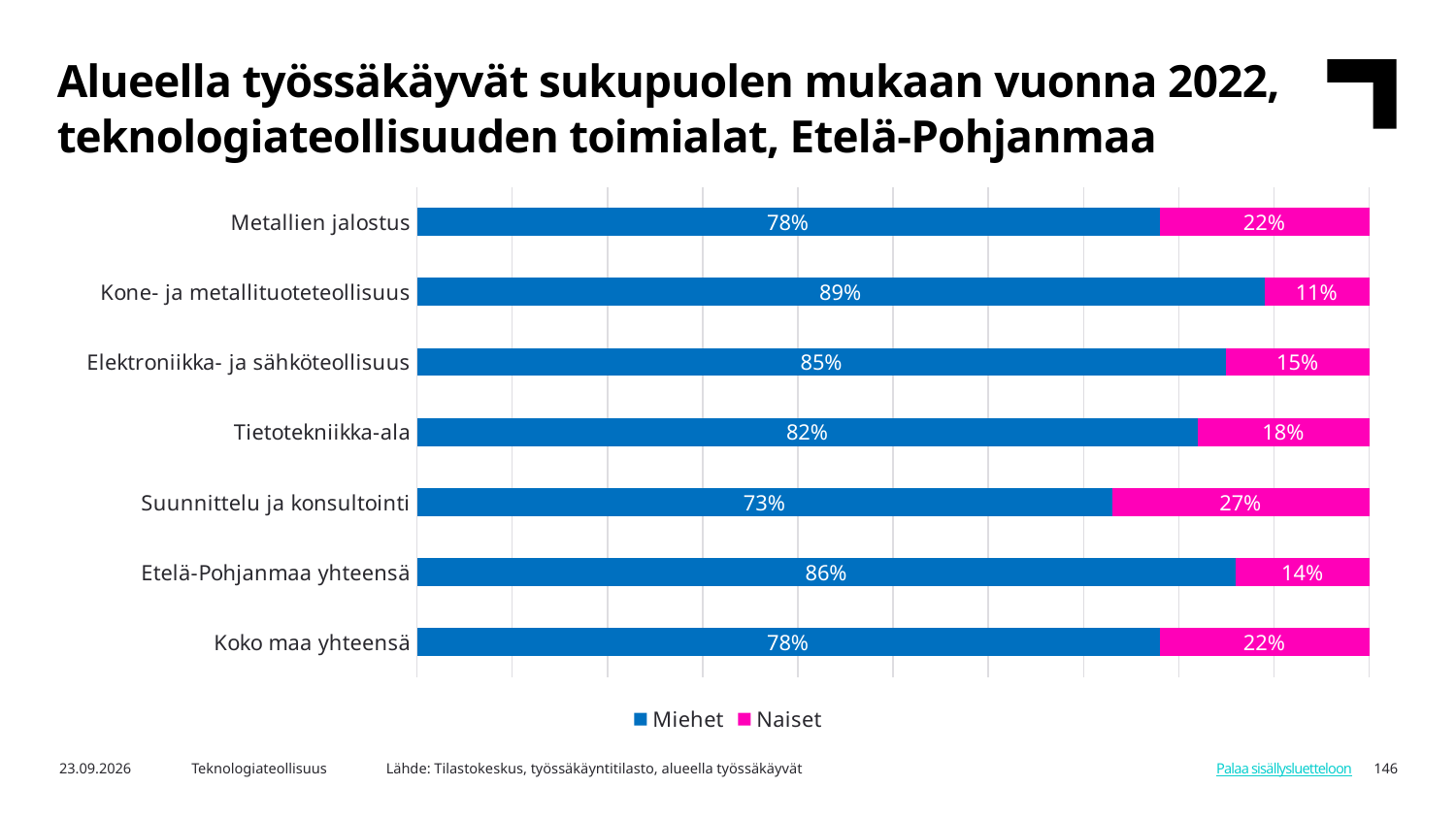
What is the Miehet share for Tietotekniikka-ala? 82% What kind of chart is shown on the slide? Stacked bar chart What is the difference between the Miehet share for Kone- ja metallituoteteollisuus and for Suunnittelu ja konsultointi? 16 percentage points Which category has the highest Naiset share? Suunnittelu ja konsultointi How many categories are shown on the chart? 7 What is the Naiset share for Etelä-Pohjanmaa yhteensä? 14% How many series does the legend list? 2 What is the Miehet share for Kone- ja metallituoteteollisuus? 89% What is the Naiset share for Suunnittelu ja konsultointi? 27% Which category has the lowest Naiset share? Kone- ja metallituoteteollisuus What is the total of the stacked bar for Koko maa yhteensä? 100% Which has a larger Naiset share, Elektroniikka- ja sähköteollisuus or Tietotekniikka-ala? Tietotekniikka-ala